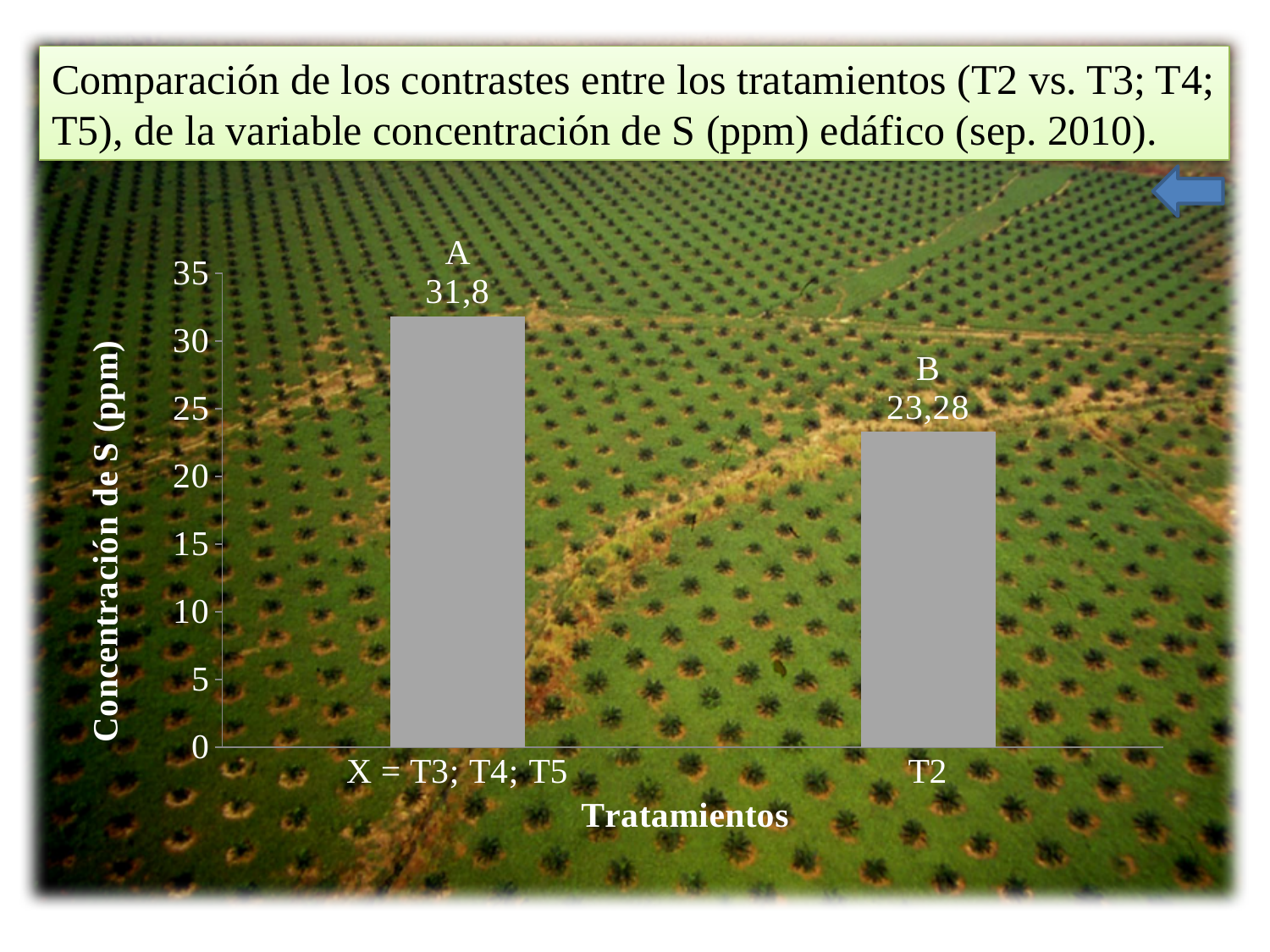
What kind of chart is shown on the slide? bar chart What is the S concentration value for the category 'X = T3; T4; T5'? 31,8 What letter is printed above the bar for T2? B Is the value for 'X = T3; T4; T5' greater or less than 30? greater What is the S concentration value for T2? 23,28 Which is larger, the value for 'X = T3; T4; T5' or the value for T2? X = T3; T4; T5 What is the label of the y axis? Concentración de S (ppm) Which category has the lowest S concentration? T2 Which category has the highest S concentration? X = T3; T4; T5 Is the value for T2 greater or less than 25? less What is the difference between the S concentration for 'X = T3; T4; T5' and for T2? 8,52 How many categories are shown on the x axis? 2